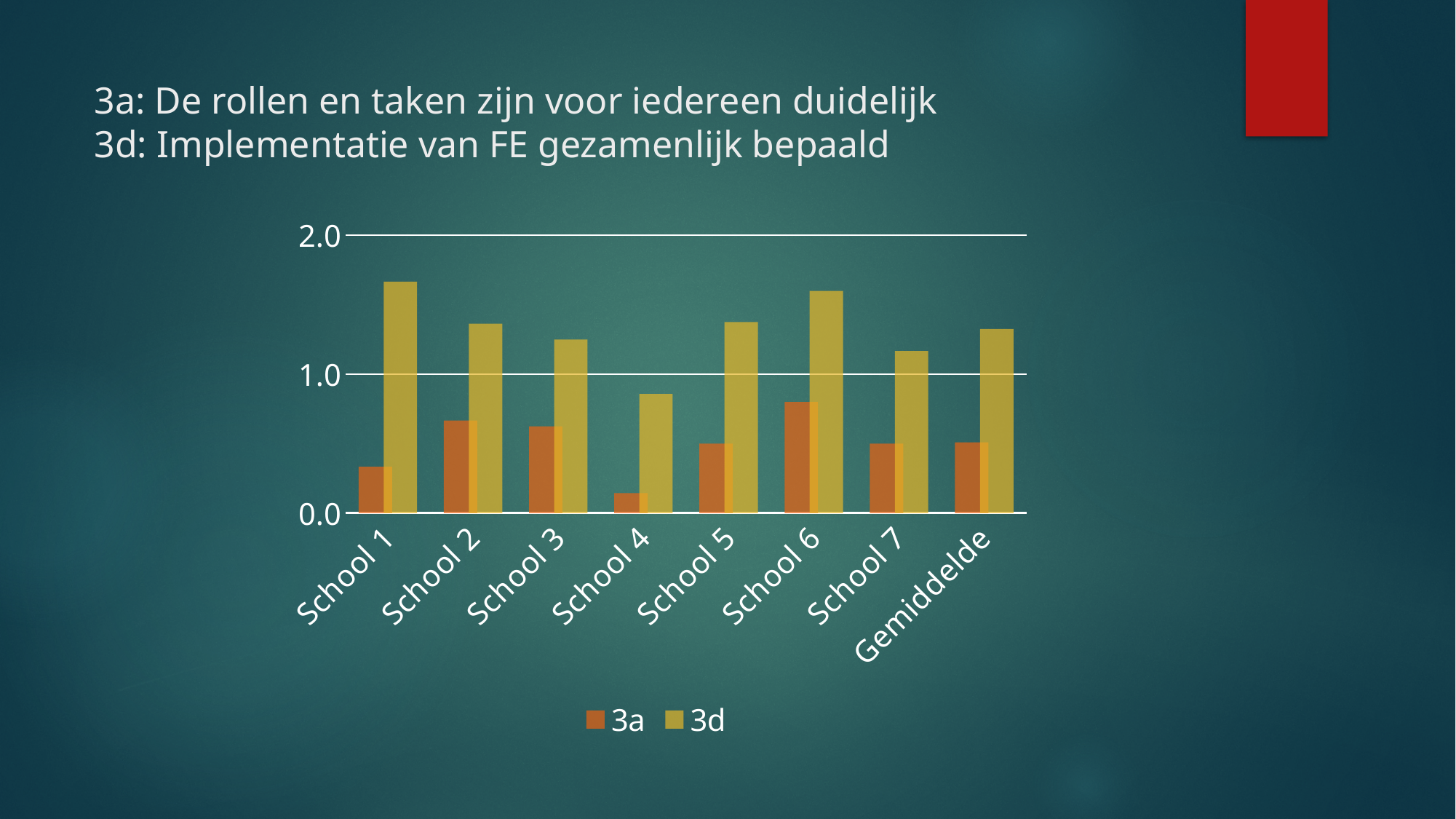
What kind of chart is shown on the slide? bar chart How many series does the chart's legend list? 2 Which category has the lowest 3a value? School 4 Is the 3d value for Gemiddelde greater or less than 1.0? greater Is the 3d value for School 4 greater or less than 1.0? less Is the 3d value for School 1 greater or less than 1.0? greater Which series are listed in the chart's legend? 3a and 3d Which category has the lowest 3d value? School 4 How many categories are shown on the x axis of the chart? 8 Which category has the highest 3a value? School 6 For School 1, which series has the larger value, 3a or 3d? 3d